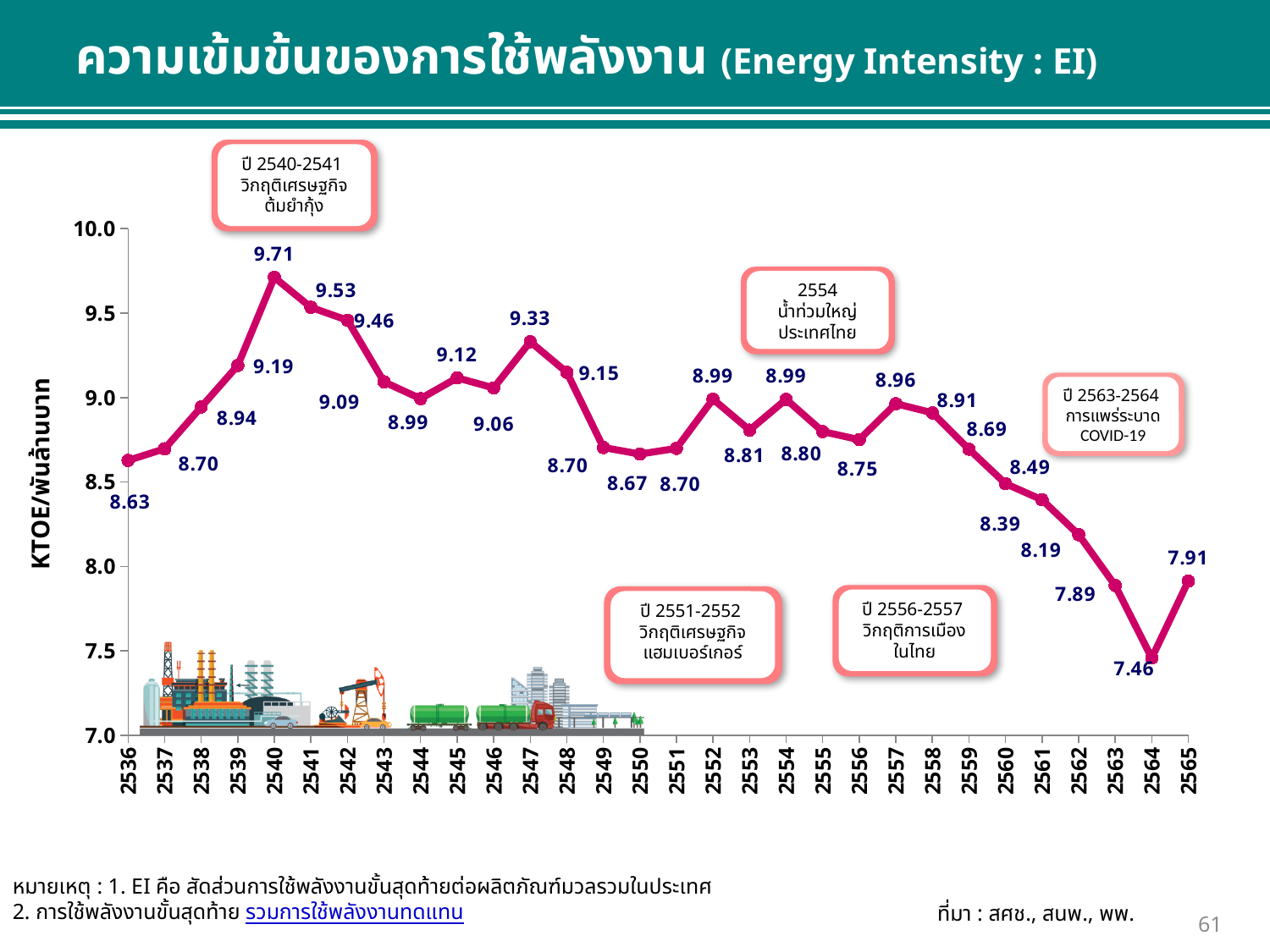
What is the label on the vertical axis of the chart? KTOE/พันล้านบาท Which year has the larger value, 2547 or 2548? 2547 What is the value shown for the year 2536? 8.63 Which year has the lowest Energy Intensity value on the chart? 2564 What is the difference between the highest value (2540) and the lowest value (2564)? 2.25 What type of chart is shown on the slide? line chart How many years (data points) are plotted on the chart? 30 What is the Energy Intensity value for the year 2540? 9.71 What is the value plotted for the year 2564? 7.46 What is the value shown for the year 2565? 7.91 Which year has the highest Energy Intensity value on the chart? 2540 Is the value for the year 2562 greater or less than 8.5? less